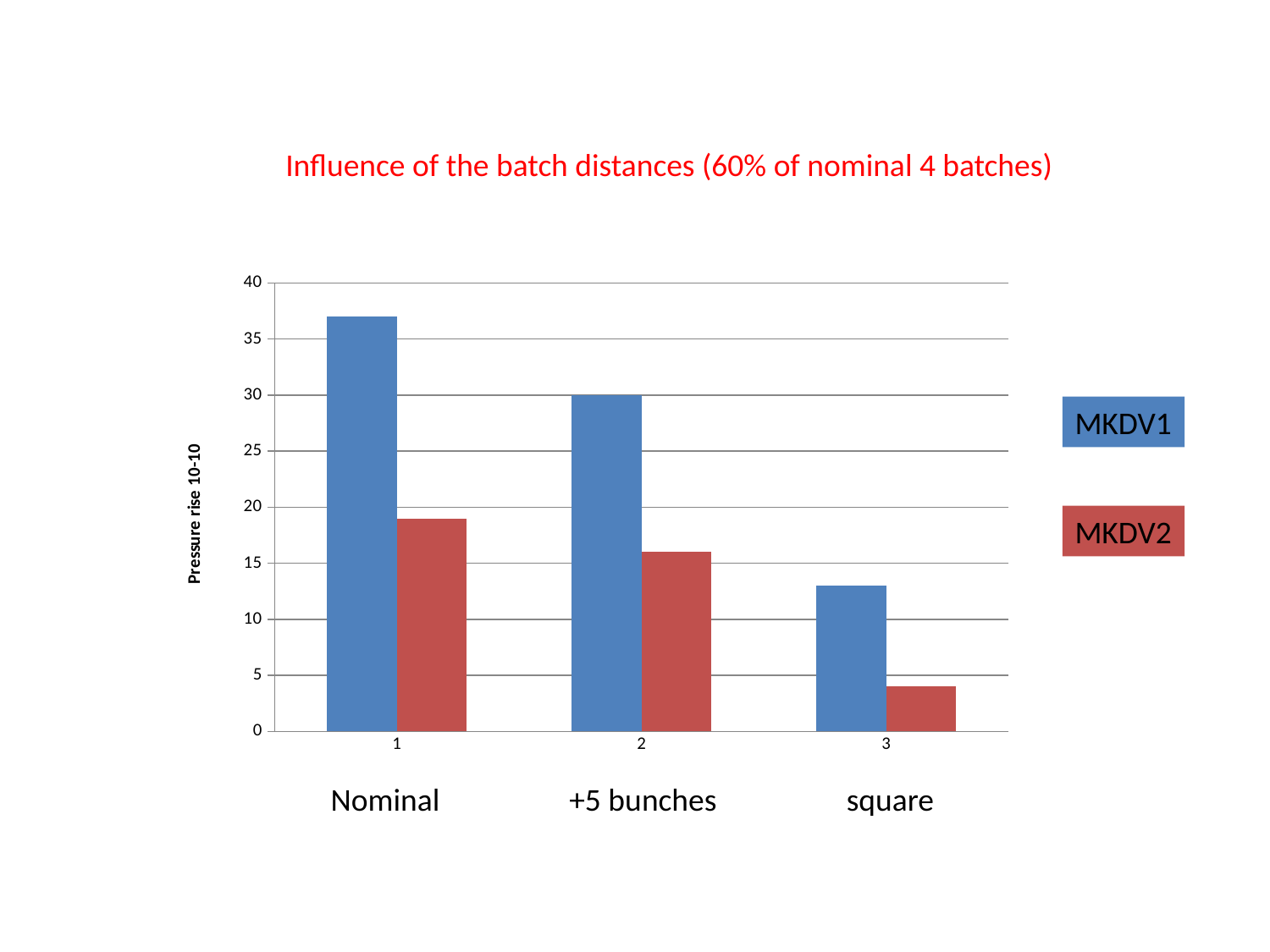
Which category has the lowest MKDV2 value? square Is the MKDV2 value for square greater or less than 5? less What is the title of the vertical axis? Pressure rise 10-10 Which category has the highest MKDV1 value? Nominal Do the MKDV1 values rise or fall from Nominal to square along the x axis? fall Is the MKDV1 value for Nominal greater or less than 35? greater Is the MKDV2 value for Nominal greater or less than 20? less For +5 bunches, which series has the larger value, MKDV1 or MKDV2? MKDV1 What kind of chart is shown on the slide? bar chart How many series does the legend list? 2 How many categories are plotted along the x axis? 3